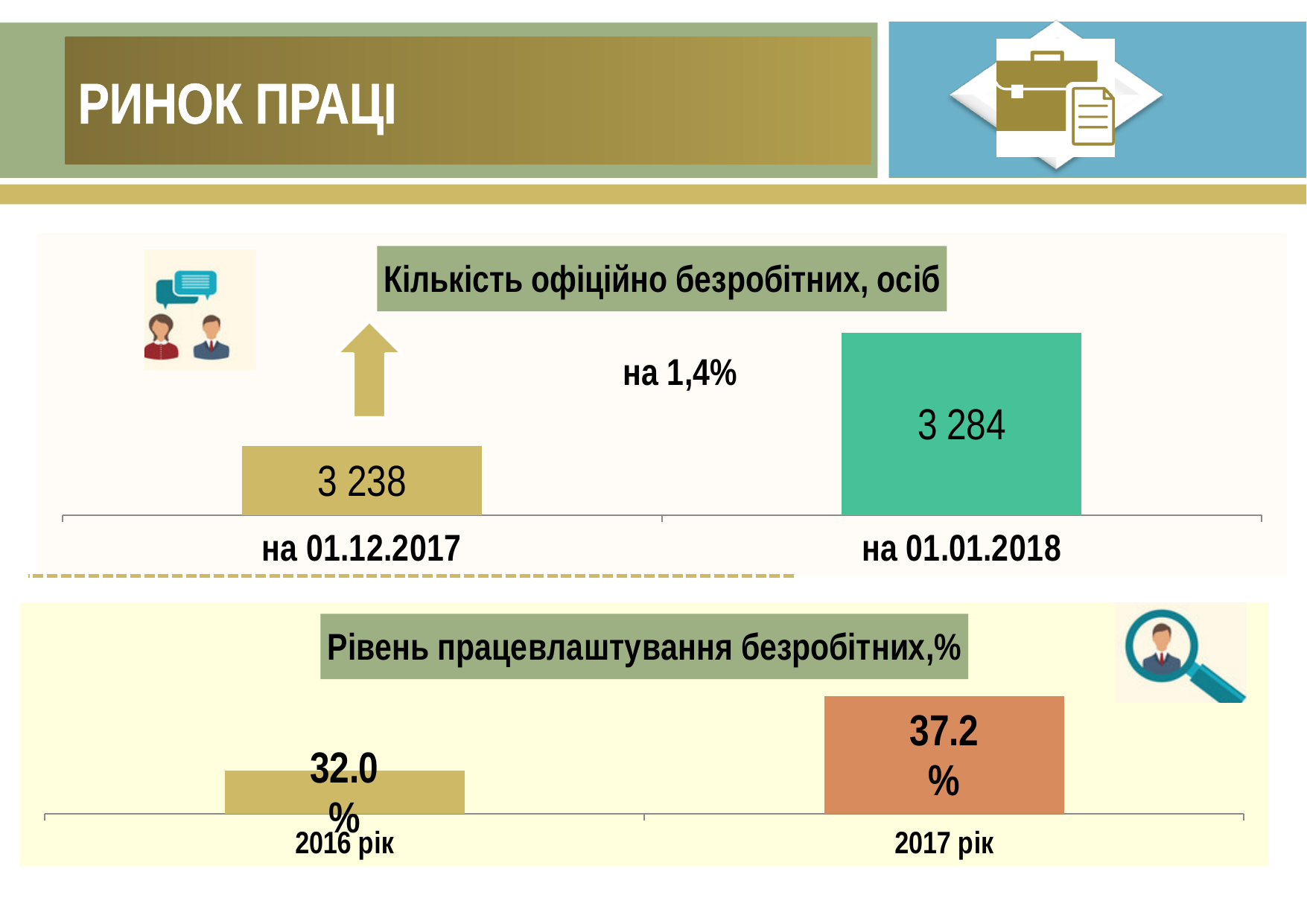
In the chart 'Кількість офіційно безробітних, осіб', what is the value for 'на 01.01.2018'? 3 284 In the chart 'Кількість офіційно безробітних, осіб', what is the difference between the values for 01.01.2018 and 01.12.2017? 46 In the chart 'Кількість офіційно безробітних, осіб', how many bars are plotted? 2 In the chart 'Кількість офіційно безробітних, осіб', what percentage increase is annotated next to the arrow? 1,4% In the chart 'Рівень працевлаштування безробітних,%', what is the value for '2016 рік'? 32.0% In the chart 'Рівень працевлаштування безробітних,%', by how many percentage points does 2017 exceed 2016? 5.2 In the chart 'Рівень працевлаштування безробітних,%', what is the value for '2017 рік'? 37.2% In the chart 'Кількість офіційно безробітних, осіб', do the values rise or fall from 01.12.2017 to 01.01.2018? rise In the chart 'Кількість офіційно безробітних, осіб', which date has the higher value? на 01.01.2018 In the chart 'Рівень працевлаштування безробітних,%', which year has the lower value? 2016 рік What type of chart is 'Рівень працевлаштування безробітних,%'? bar chart In the chart 'Кількість офіційно безробітних, осіб', what is the value for 'на 01.12.2017'? 3 238